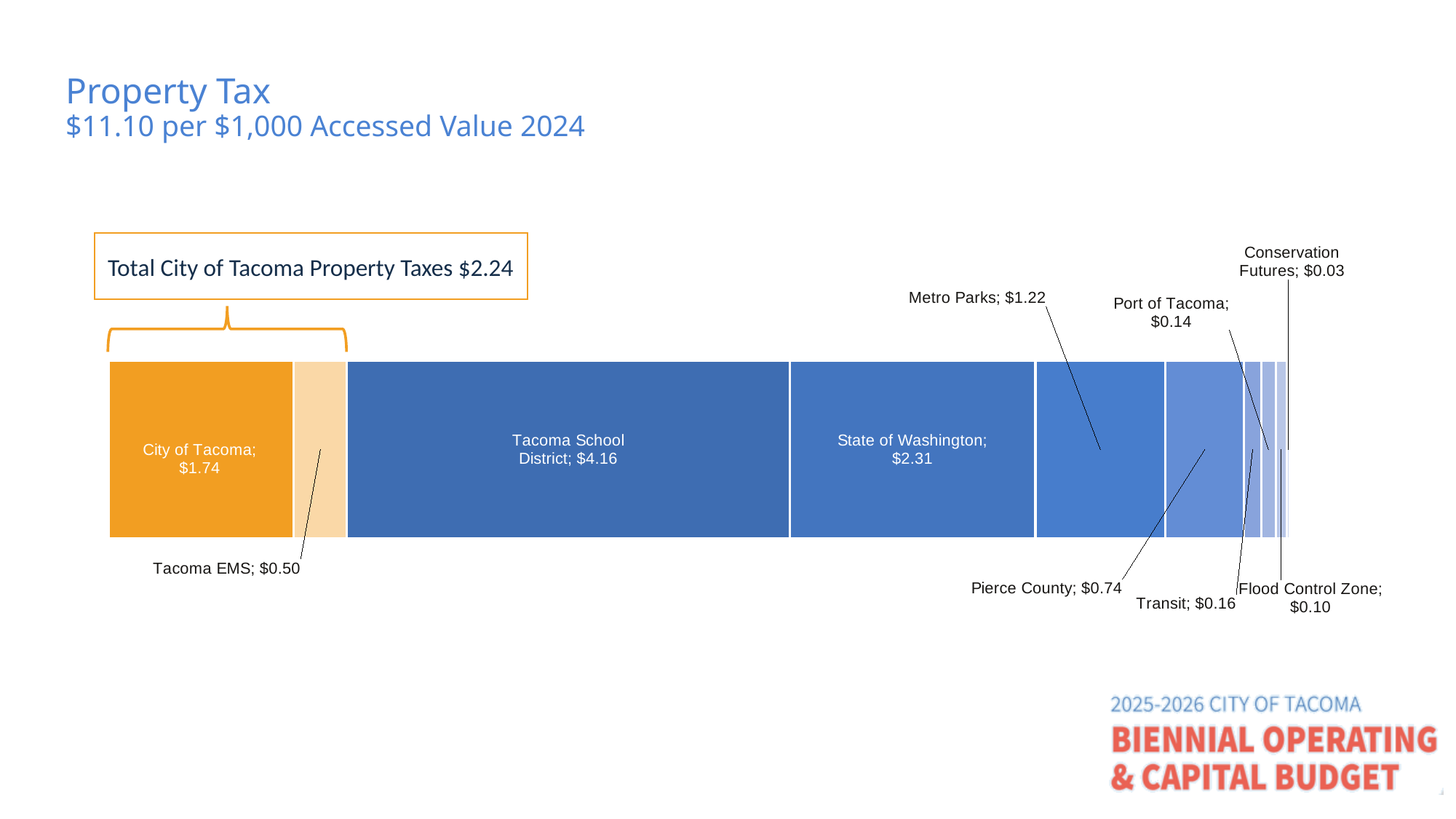
What is the total of the City of Tacoma and Tacoma EMS segments, as shown in the box above the bar? $2.24 What kind of chart is shown on the slide? Stacked bar chart What is the value for State of Washington? $2.31 What is the value for Conservation Futures? $0.03 Which is larger, the value for Metro Parks or the value for Pierce County? Metro Parks What is the value for Tacoma School District? $4.16 How many segments does the bar contain? 10 What is the difference between the Tacoma School District value and the State of Washington value? $1.85 Which segment has the highest value? Tacoma School District What is the title of the chart? Property Tax What is the value for Tacoma EMS? $0.50 Which segment has the lowest value? Conservation Futures